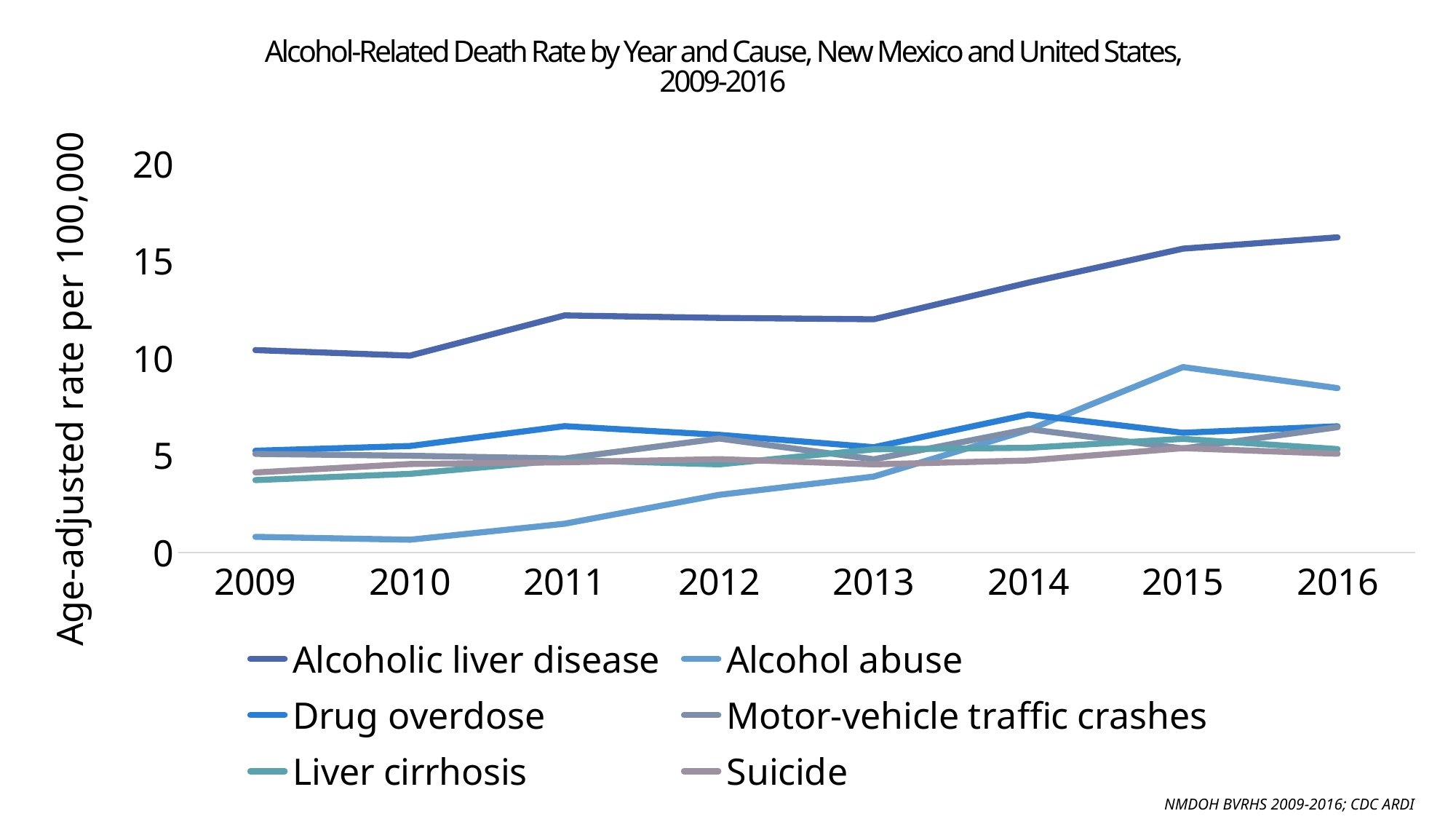
In which year does the Alcohol abuse line reach its highest value? 2015 How many series does the legend list? 6 Is the value for Alcohol abuse in 2015 greater or less than 10? less Which cause has the lowest death rate in 2009? Alcohol abuse Is the value for Alcohol abuse in 2009 greater or less than 5? less How many years are plotted along the x axis? 8 In 2009, which is larger: the rate for Alcoholic liver disease or the rate for Drug overdose? Alcoholic liver disease What kind of chart is shown on the slide? line chart Which cause has the highest death rate in 2016? Alcoholic liver disease What is the label on the y axis? Age-adjusted rate per 100,000 Is the value for Alcoholic liver disease in 2016 greater or less than 15? greater Does the Alcoholic liver disease death rate rise or fall overall from 2009 to 2016? rise